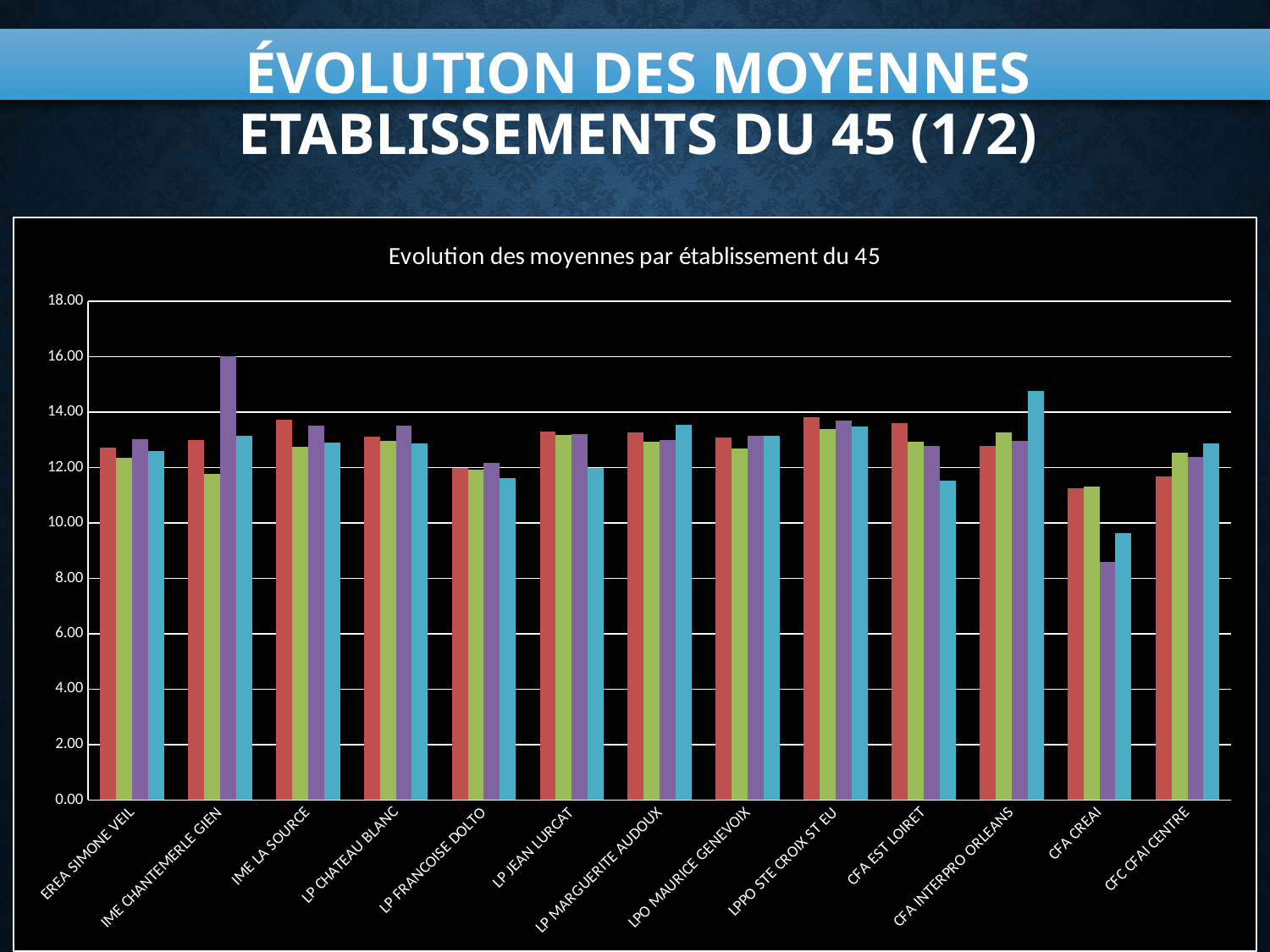
Which establishment has the tallest bar in the chart? IME CHANTEMERLE GIEN Is the value of the red bar for CFA CREAI greater or less than 10.00? greater How many bars are plotted for each establishment in the chart? 4 How many establishments (categories) are shown on the x axis of the chart? 13 What is the highest value shown on the y axis of the chart? 18.00 For IME CHANTEMERLE GIEN, which is larger: the purple bar or the green bar? The purple bar Is the value of the cyan bar for CFA INTERPRO ORLEANS greater or less than 14.00? greater Is the value of the purple bar for CFA CREAI greater or less than 10.00? less What is the title of the chart? Evolution des moyennes par établissement du 45 Which establishment has the shortest bar in the chart? CFA CREAI What kind of chart is shown on the slide? Bar chart